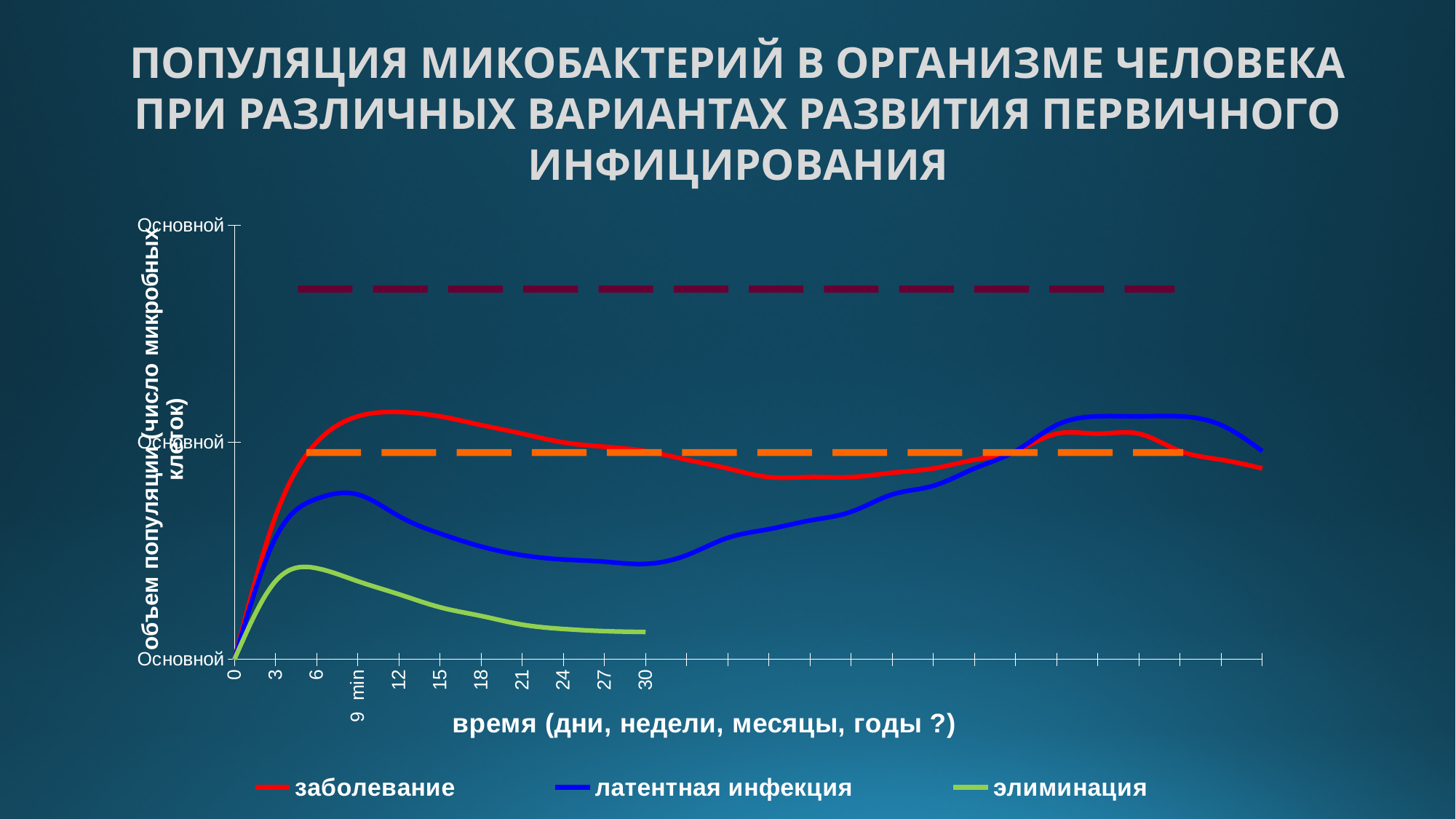
Does the заболевание line rise or fall between x = 12 and x = 24? fall Which series has the lowest value at x = 12? элиминация Which series is drawn in red according to the legend? заболевание Which series ends at the lowest value at the right end of its line? элиминация How many series does the legend list? 3 Which series is drawn in green according to the legend? элиминация Does the элиминация line rise or fall between x = 6 and x = 30? fall Does the латентная инфекция line rise or fall between x = 0 and x = 6? rise What kind of chart is shown on the slide? line chart At x = 6, which is larger: the value for латентная инфекция or the value for элиминация? латентная инфекция At x = 30, which is larger: the value for заболевание or the value for элиминация? заболевание Which series has the highest value at x = 12? заболевание